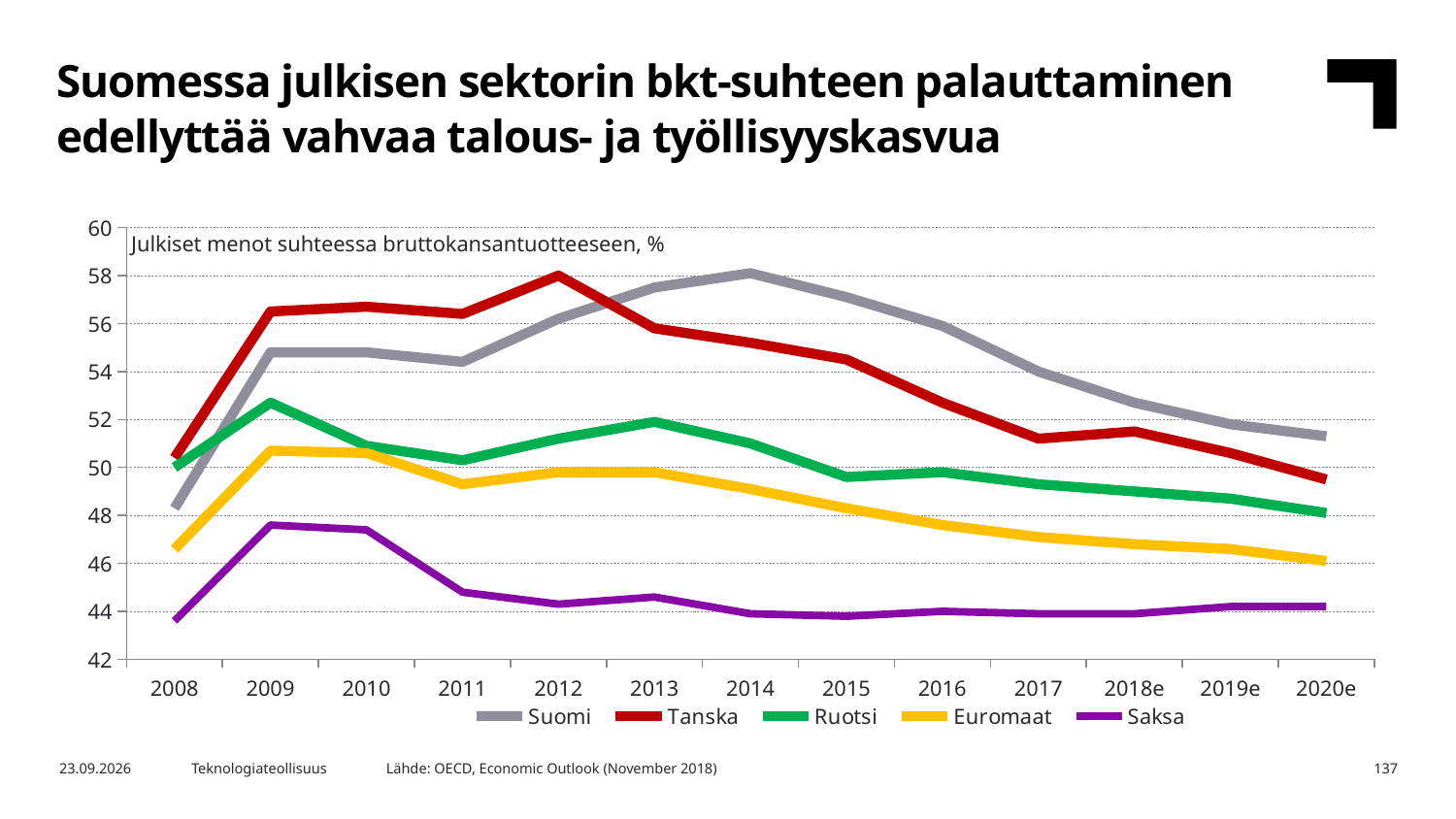
Does the value for Euromaat rise or fall from 2013 to 2020e? fall Which series has the highest value in 2012? Tanska Which series has the lowest value in 2016? Saksa What is the subtitle text shown inside the chart area? Julkiset menot suhteessa bruttokansantuotteeseen, % Is the value for Euromaat in 2020e greater or less than 48? less Is the value for Suomi in 2014 greater or less than 56? greater How many years are shown on the x axis? 13 In 2014, which is larger: the value for Suomi or the value for Tanska? Suomi In 2009, which is larger: the value for Tanska or the value for Suomi? Tanska Which series has the highest value in 2017? Suomi What kind of chart is shown on the slide? line chart How many series does the legend list? 5